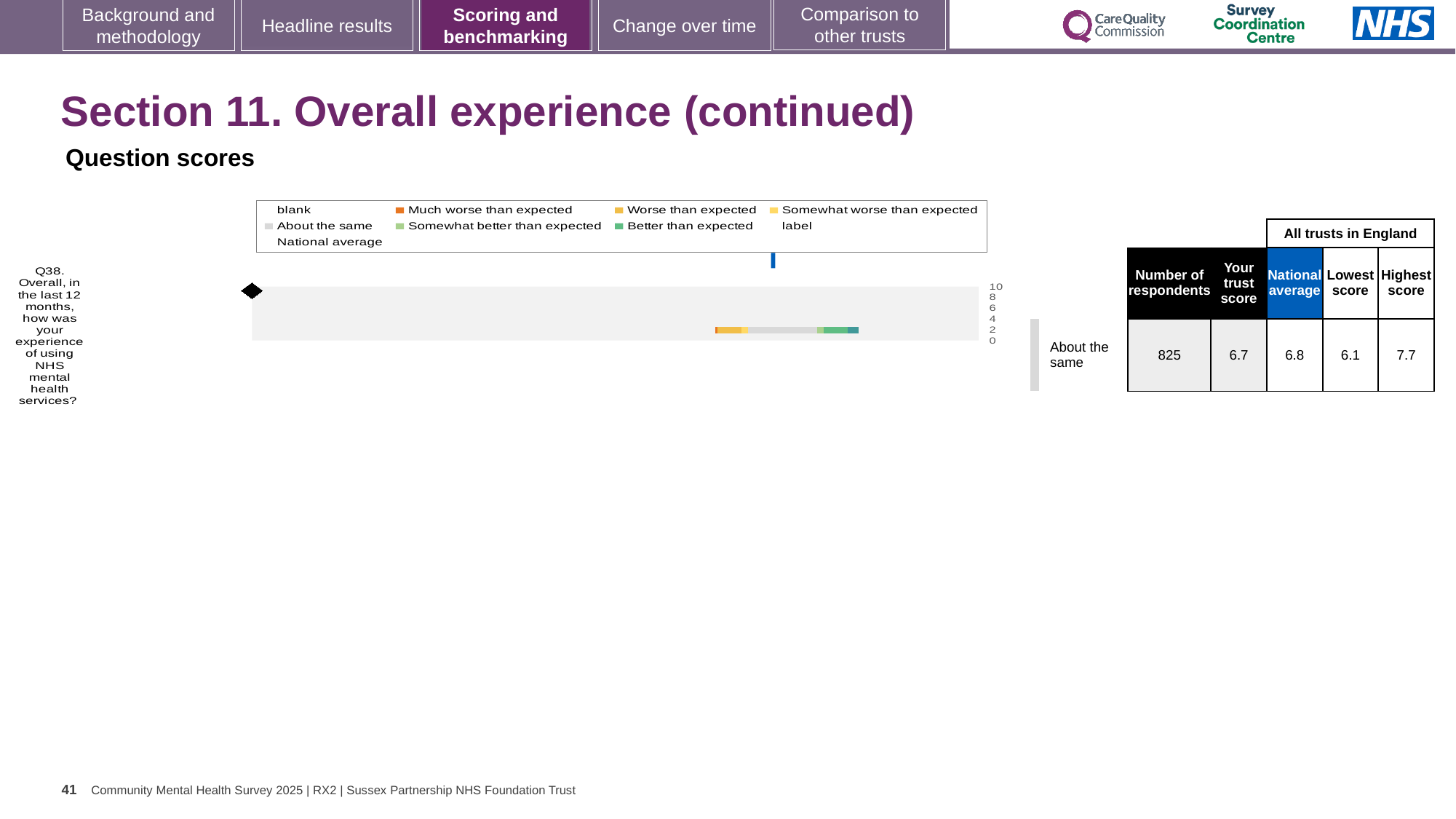
What is the number of respondents for Q38? 825 What is the benchmark category shown for Q38 next to the chart? About the same Which is larger for Q38, the trust's score or the national average? national average What is the difference between the highest and lowest trust scores for Q38? 1.6 What is the national average score for Q38? 6.8 Which legend entry is shown in orange? Much worse than expected What is the highest score among all trusts in England for Q38? 7.7 How many survey questions are plotted in the chart? 1 What kind of chart is used to show the question score for Q38? bar chart What is the lowest score among all trusts in England for Q38? 6.1 What is the highest value shown on the chart's score axis? 10 What is the trust's score for Q38? 6.7